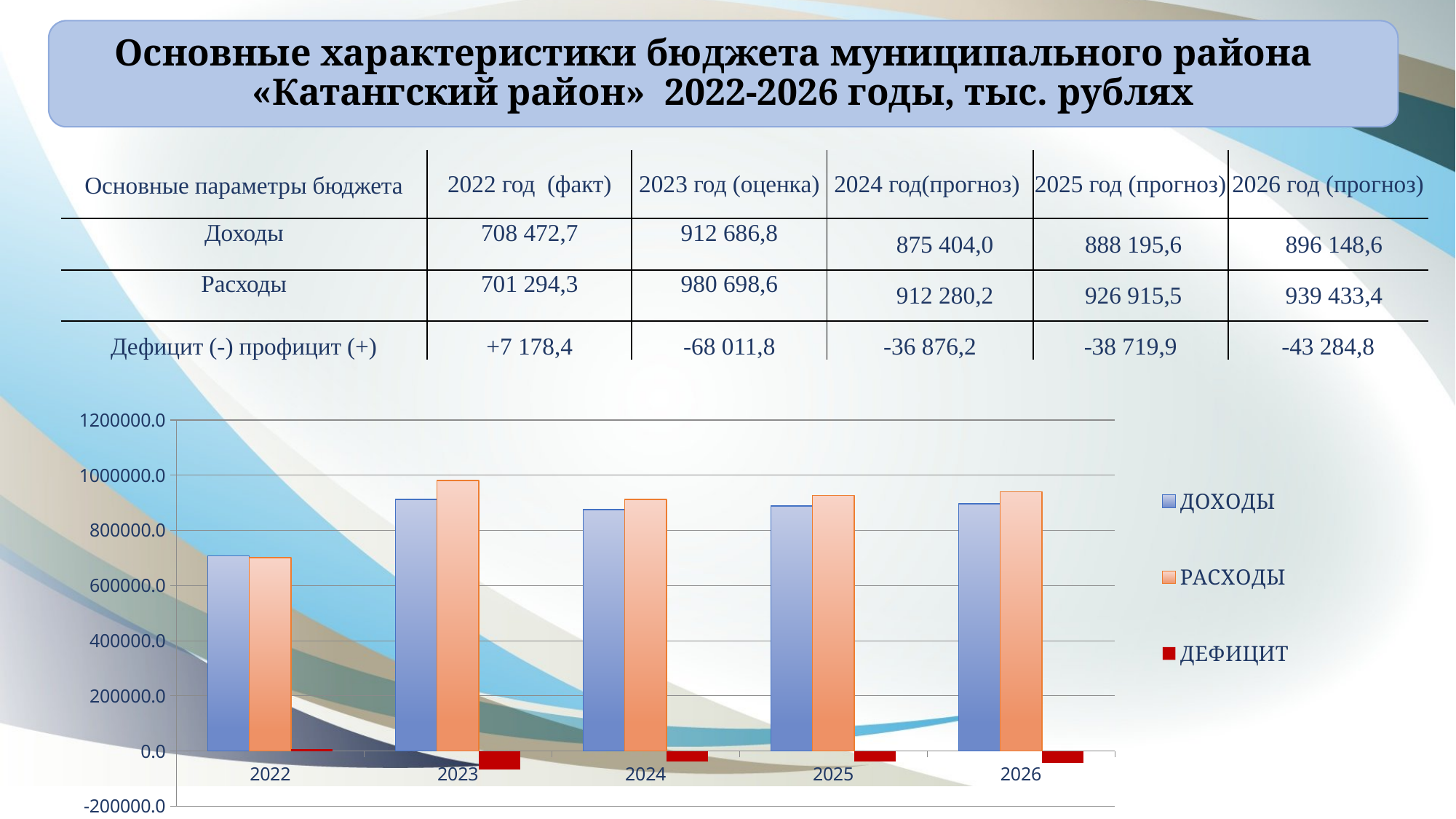
What kind of chart is shown on the slide? bar chart Is the ДОХОДЫ value for 2022 greater or less than 800000? less In 2023, which bar is taller: ДОХОДЫ or РАСХОДЫ? РАСХОДЫ Do the ДОХОДЫ bars rise or fall from 2022 to 2023? rise How many years are shown on the x axis of the chart? 5 According to the table, what is the ДОХОДЫ value for 2024? 875 404,0 In which year is the РАСХОДЫ bar the highest? 2023 How many series does the chart legend list? 3 Is the РАСХОДЫ value for 2023 greater or less than 1000000? less According to the table, what is the РАСХОДЫ value for 2026? 939 433,4 In which year is the ДОХОДЫ bar the lowest? 2022 What colour are the ДЕФИЦИТ bars in the chart? dark red